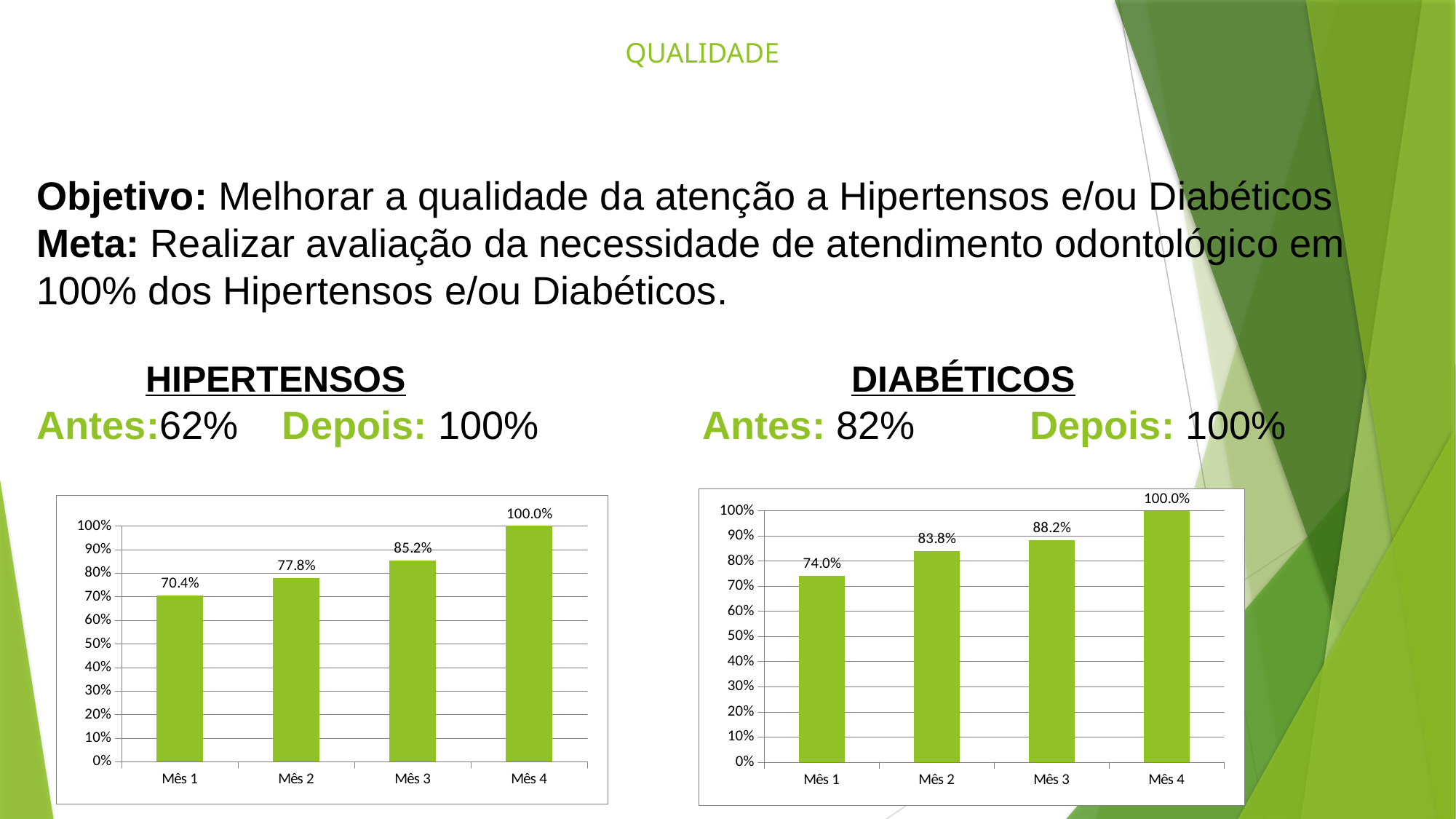
What kind of chart is the DIABÉTICOS chart (right)? Bar chart In the HIPERTENSOS chart (left), do the values rise or fall from Mês 1 to Mês 4? Rise In the DIABÉTICOS chart (right), what is the value for Mês 4? 100.0% In the HIPERTENSOS chart (left), how many months are plotted? 4 Which is larger: the Mês 1 value in the HIPERTENSOS chart or the Mês 1 value in the DIABÉTICOS chart? DIABÉTICOS chart (74.0%) In the DIABÉTICOS chart (right), which month has the highest value? Mês 4 In the HIPERTENSOS chart (left), which month has the lowest value? Mês 1 In the DIABÉTICOS chart (right), what is the difference between the values for Mês 3 and Mês 2? 4.4% In the HIPERTENSOS chart (left), what is the value for Mês 1? 70.4% In the HIPERTENSOS chart (left), what is the difference between the values for Mês 2 and Mês 1? 7.4% In the DIABÉTICOS chart (right), what is the value for Mês 2? 83.8% In the HIPERTENSOS chart (left), what is the value for Mês 3? 85.2%